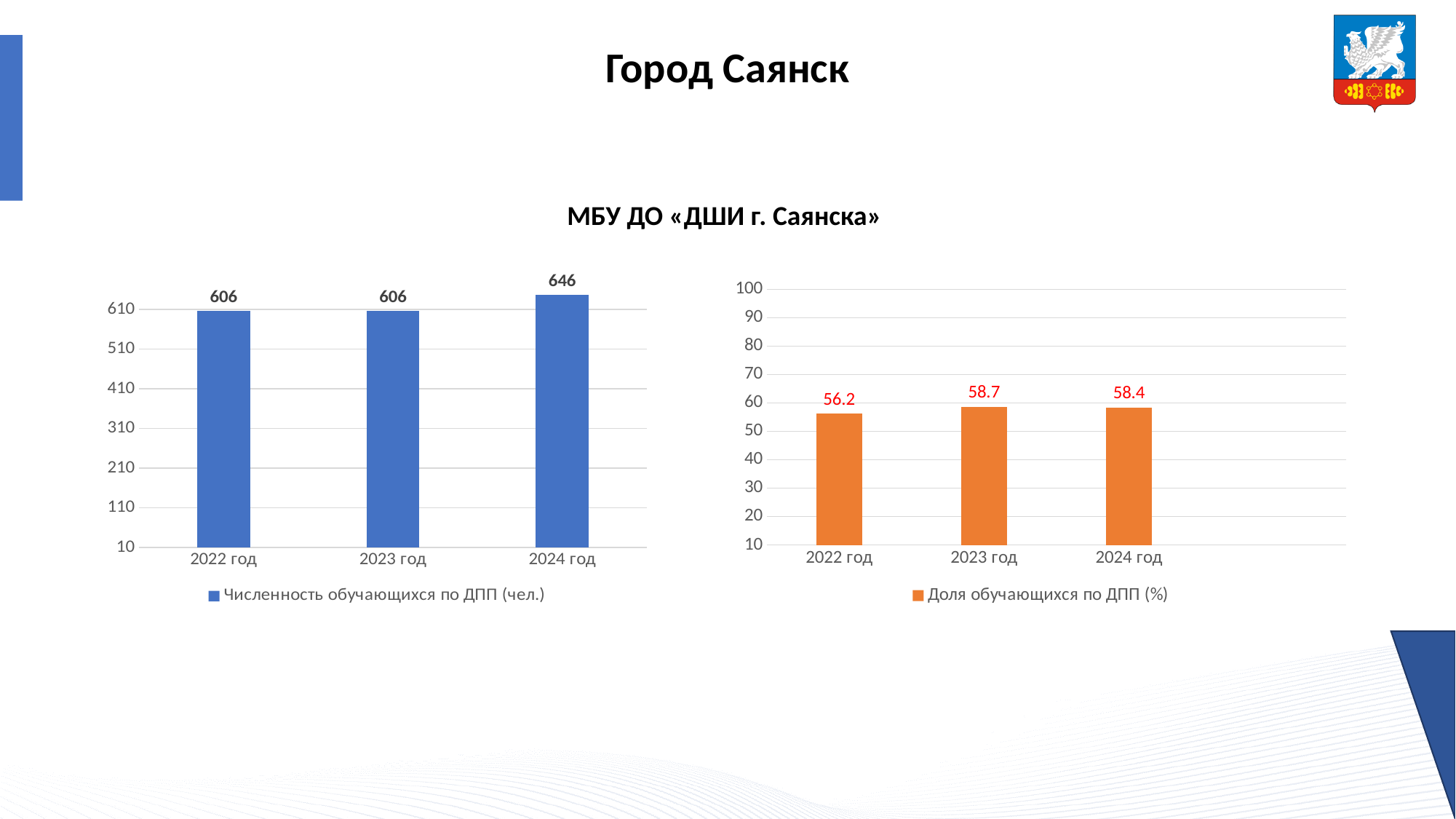
In the left chart (Численность обучающихся по ДПП), what is the value for 2024 год? 646 In the right chart (Доля обучающихся по ДПП), is the value for 2024 год greater or less than 50? greater In the left chart (Численность обучающихся по ДПП), what is the difference between the values for 2024 год and 2023 год? 40 In the right chart (Доля обучающихся по ДПП), what is the difference between the values for 2023 год and 2022 год? 2.5 In the right chart (Доля обучающихся по ДПП), which year has the lowest value? 2022 год In the left chart (Численность обучающихся по ДПП), what is the value for 2022 год? 606 How many years are shown on the x axis of the left chart (Численность обучающихся по ДПП)? 3 What is the legend entry of the left chart? Численность обучающихся по ДПП (чел.) What type of chart is the right chart (Доля обучающихся по ДПП)? bar chart In the left chart (Численность обучающихся по ДПП), which year has the highest value? 2024 год In the right chart (Доля обучающихся по ДПП), what is the value for 2022 год? 56.2 In the right chart (Доля обучающихся по ДПП), what is the value for 2023 год? 58.7